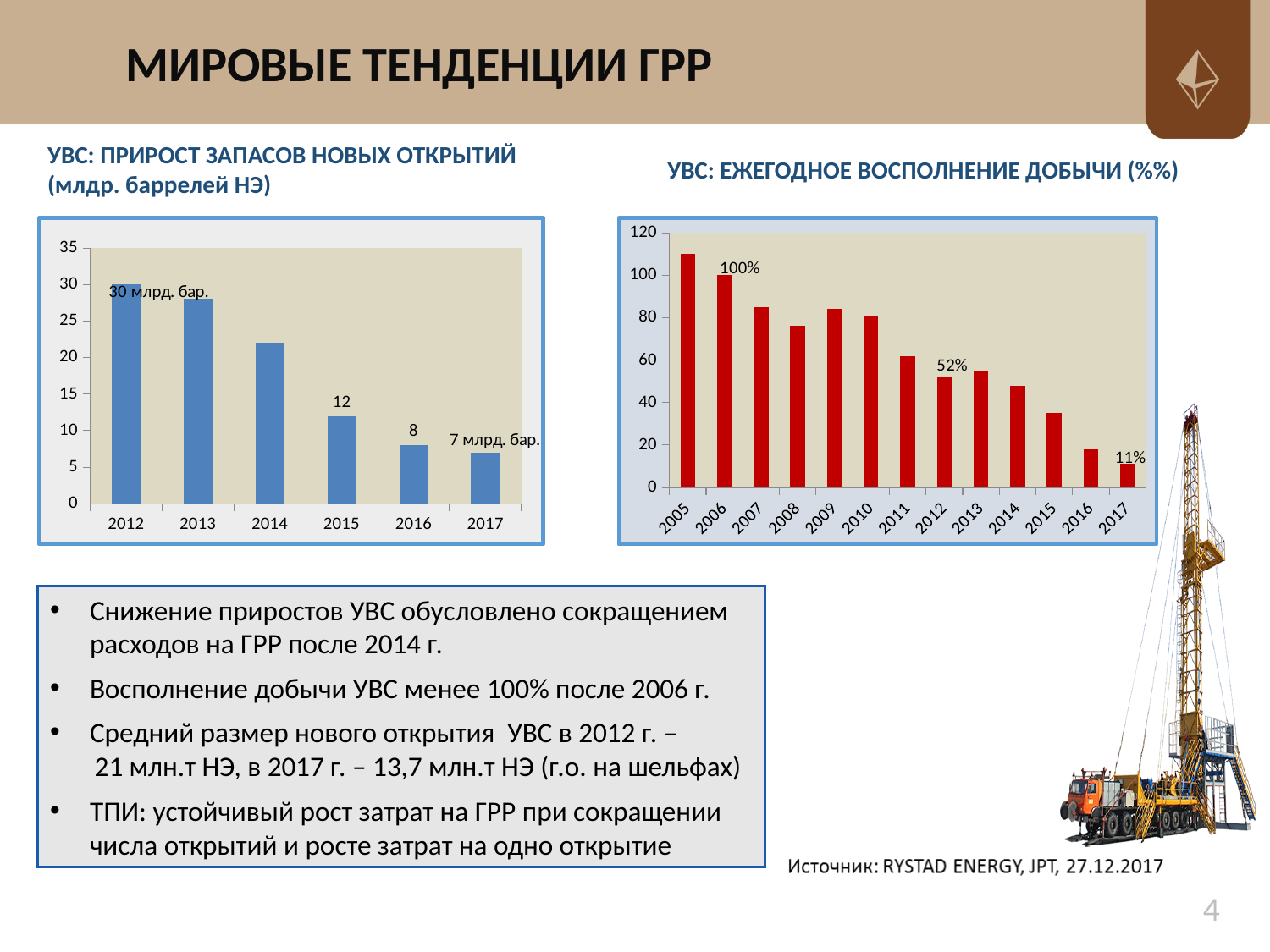
In the chart 'УВС: ЕЖЕГОДНОЕ ВОСПОЛНЕНИЕ ДОБЫЧИ (%)', how many years are shown on the x axis? 13 In the chart 'УВС: ПРИРОСТ ЗАПАСОВ НОВЫХ ОТКРЫТИЙ', what is the value for 2017? 7 млрд. бар. In the chart 'УВС: ПРИРОСТ ЗАПАСОВ НОВЫХ ОТКРЫТИЙ', which year has the highest value? 2012 In the chart 'УВС: ЕЖЕГОДНОЕ ВОСПОЛНЕНИЕ ДОБЫЧИ (%)', what is the value for 2017? 11% In the chart 'УВС: ПРИРОСТ ЗАПАСОВ НОВЫХ ОТКРЫТИЙ', how many years are shown on the x axis? 6 In the chart 'УВС: ЕЖЕГОДНОЕ ВОСПОЛНЕНИЕ ДОБЫЧИ (%)', is the value for 2005 greater or less than 100? greater In the chart 'УВС: ПРИРОСТ ЗАПАСОВ НОВЫХ ОТКРЫТИЙ', what is the value for 2015? 12 In the chart 'УВС: ПРИРОСТ ЗАПАСОВ НОВЫХ ОТКРЫТИЙ', what is the difference between the values for 2015 and 2016? 4 In the chart 'УВС: ЕЖЕГОДНОЕ ВОСПОЛНЕНИЕ ДОБЫЧИ (%)', what is the value for 2012? 52% In the chart 'УВС: ПРИРОСТ ЗАПАСОВ НОВЫХ ОТКРЫТИЙ', is the value for 2013 greater or less than 25? greater In the chart 'УВС: ЕЖЕГОДНОЕ ВОСПОЛНЕНИЕ ДОБЫЧИ (%)', what is the value for 2006? 100% What kind of chart is 'УВС: ЕЖЕГОДНОЕ ВОСПОЛНЕНИЕ ДОБЫЧИ (%)'? bar chart